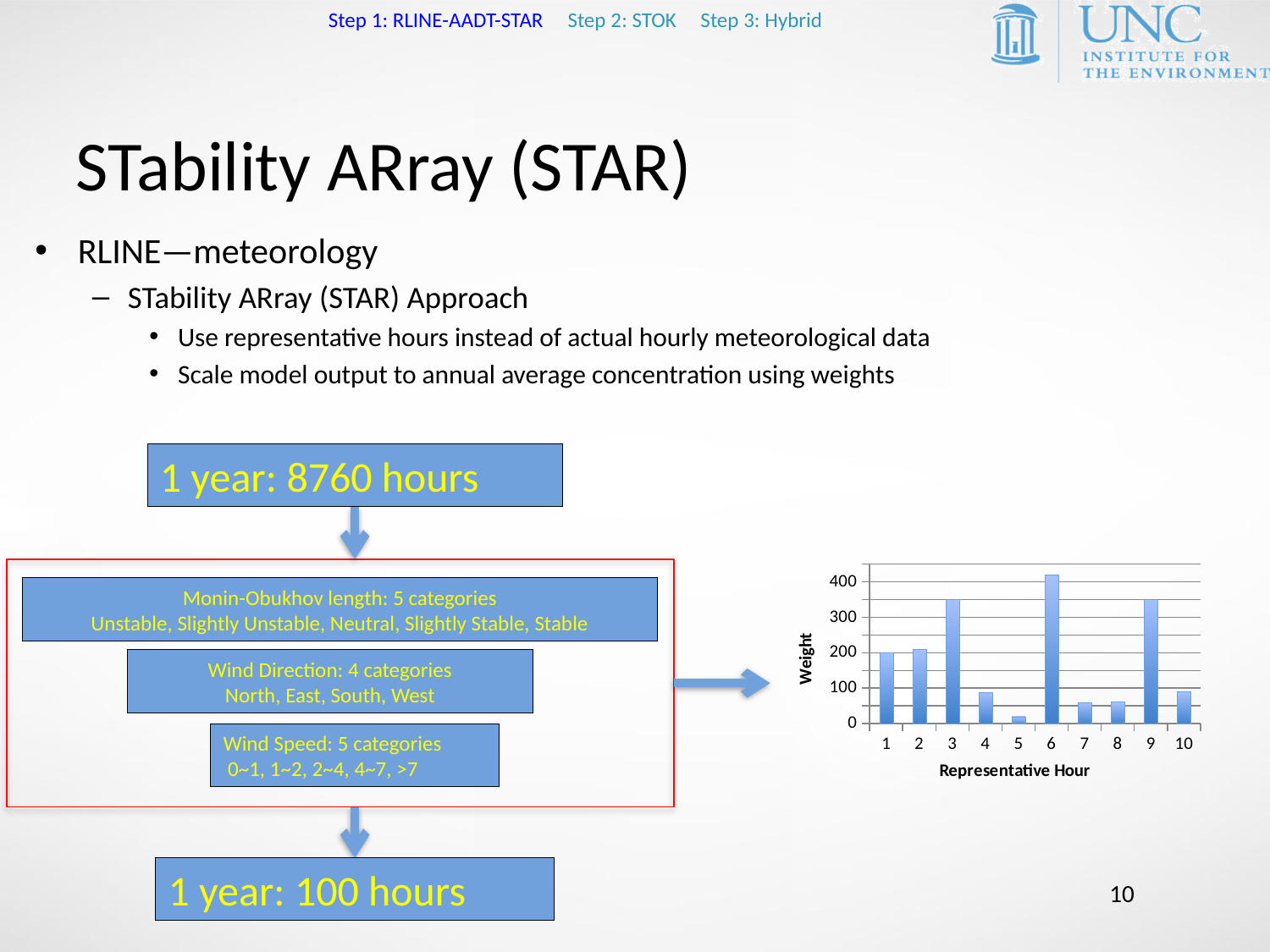
Is the weight for representative hour 5 greater or less than 100? less What is the label of the x axis of the chart? Representative Hour Which has a larger weight, representative hour 3 or representative hour 4? 3 Which representative hour has the lowest weight in the chart? 5 Which has a larger weight, representative hour 1 or representative hour 7? 1 How many representative hours are plotted on the x axis of the chart? 10 Is the weight for representative hour 6 greater or less than 400? greater What is the label of the y axis of the chart? Weight Is the weight for representative hour 3 greater or less than 300? greater What kind of chart is shown on the right of the slide? bar chart Which representative hour has the highest weight in the chart? 6